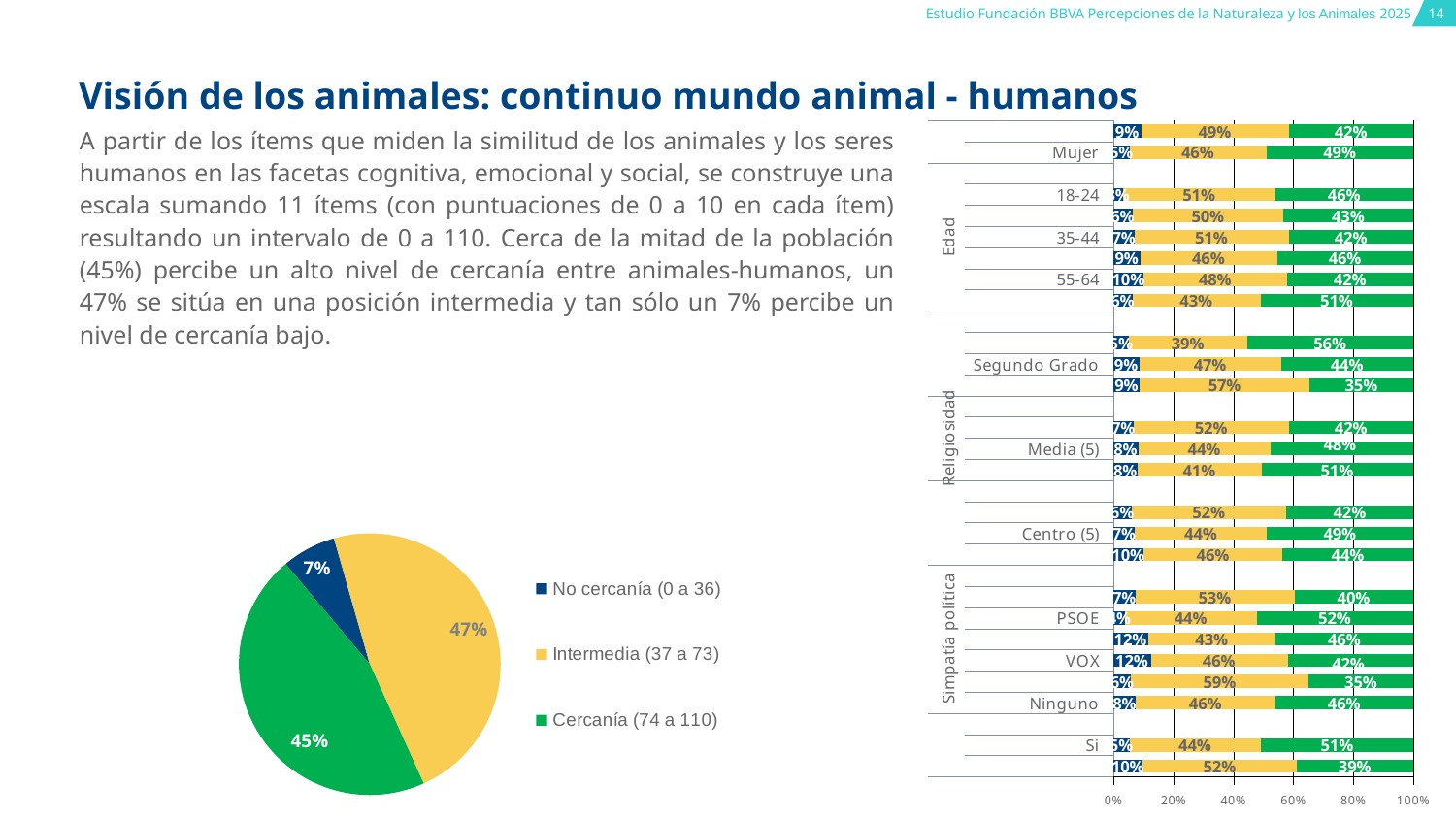
In the bar chart on the right, for 'VOX', which is larger: the yellow segment or the green segment? Yellow segment (46%) In the bar chart on the right, what is the value of the blue segment for 'VOX'? 12% What kind of chart is the chart on the right side of the slide? Stacked bar chart In the bar chart on the right, what is the value of the yellow segment for '55-64'? 48% In the pie chart on the left, which category has the largest slice? Intermedia (37 a 73) In the bar chart on the right, what is the value of the green segment for 'Mujer'? 49% In the pie chart on the left, what is the value for 'No cercanía (0 a 36)'? 7% In the pie chart on the left, which category has the smallest slice? No cercanía (0 a 36) In the bar chart on the right, what is the value of the green segment for 'PSOE'? 52% In the pie chart on the left, what share of the population falls in the 'Cercanía (74 a 110)' category? 45% In the pie chart on the left, what is the difference between the 'Intermedia (37 a 73)' and 'Cercanía (74 a 110)' slices? 2% How many categories does the legend of the pie chart on the left list? 3